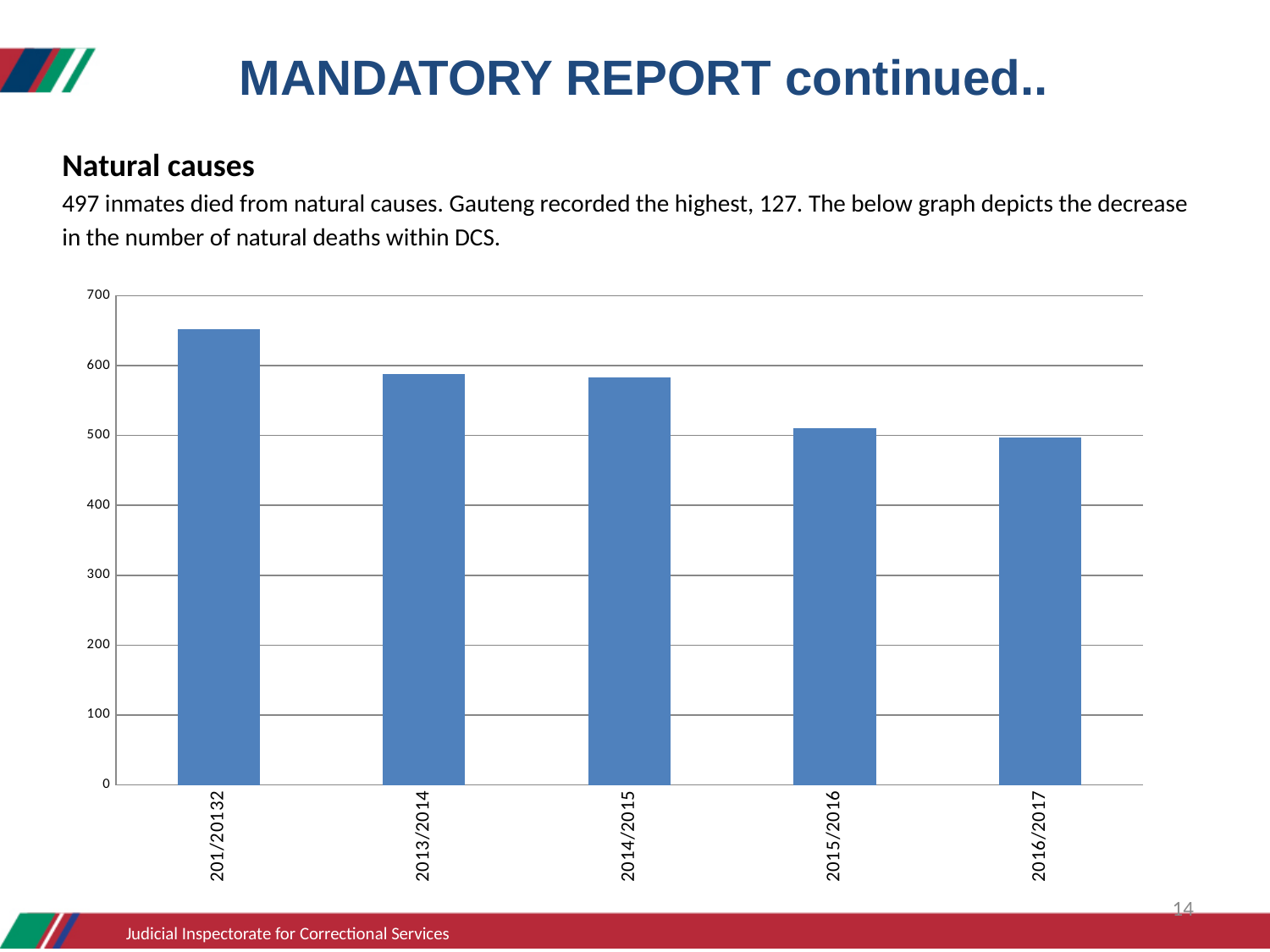
Is the value for 2014/2015 greater or less than 500? greater Is the value for 2013/2014 greater or less than 600? less Which is larger, the value for 201/20132 or the value for 2015/2016? 201/20132 How many bars (categories) does the chart show? 5 What is the highest value shown on the chart's vertical axis? 700 Which category has the highest bar in the chart? 201/20132 What kind of chart is shown on the slide? bar chart Which category has the lowest bar in the chart? 2016/2017 Do the values rise or fall from left to right along the x axis? fall Is the value for 2015/2016 greater or less than 600? less